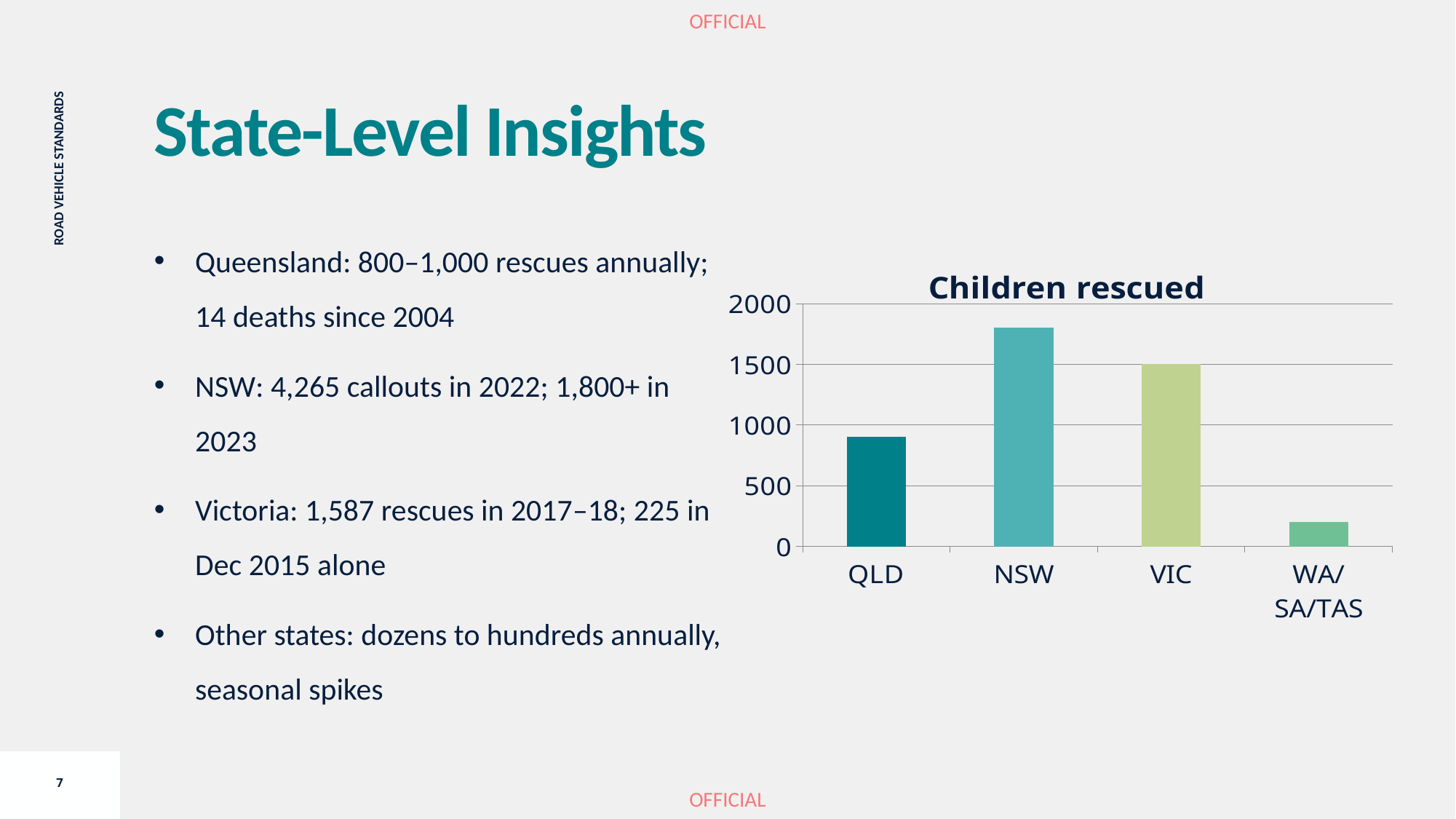
Is the value for WA/SA/TAS greater or less than 500? less How many categories are shown on the x axis of the chart? 4 Which is larger, the value for QLD or the value for WA/SA/TAS? QLD Is the value for NSW greater or less than 1500? greater Which category has the lowest number of children rescued? WA/SA/TAS Which category has the highest number of children rescued? NSW Which is larger, the value for NSW or the value for VIC? NSW What is the label of the last category on the x axis? WA/SA/TAS Is the value for QLD greater or less than 500? greater What is the title of the chart? Children rescued What kind of chart is shown on the slide? bar chart